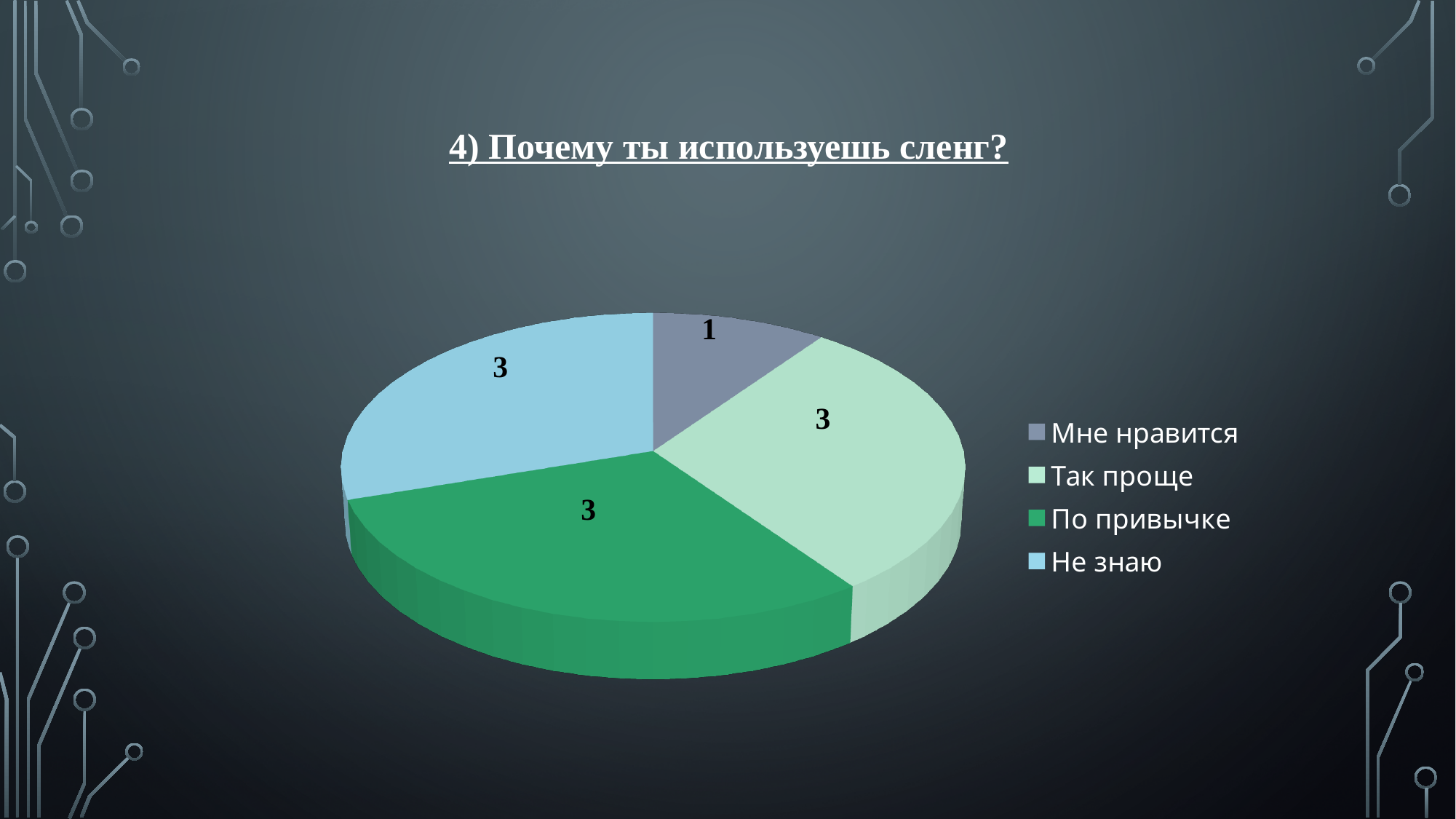
What value is shown for the "Мне нравится" slice? 1 What is the total of all the slice values in the pie chart? 10 What value is shown for the "Не знаю" slice? 3 How many categories does the pie chart show? 4 What is the title of the chart? 4) Почему ты используешь сленг? What value is shown for the "По привычке" slice? 3 What value is shown for the "Так проще" slice? 3 What share of the pie does the "Мне нравится" slice represent? 10% What kind of chart is shown on the slide? Pie chart What is the difference between the values for "Так проще" and "Мне нравится"? 2 Which category has the smallest slice of the pie? Мне нравится Which is larger, the value for "По привычке" or the value for "Мне нравится"? По привычке